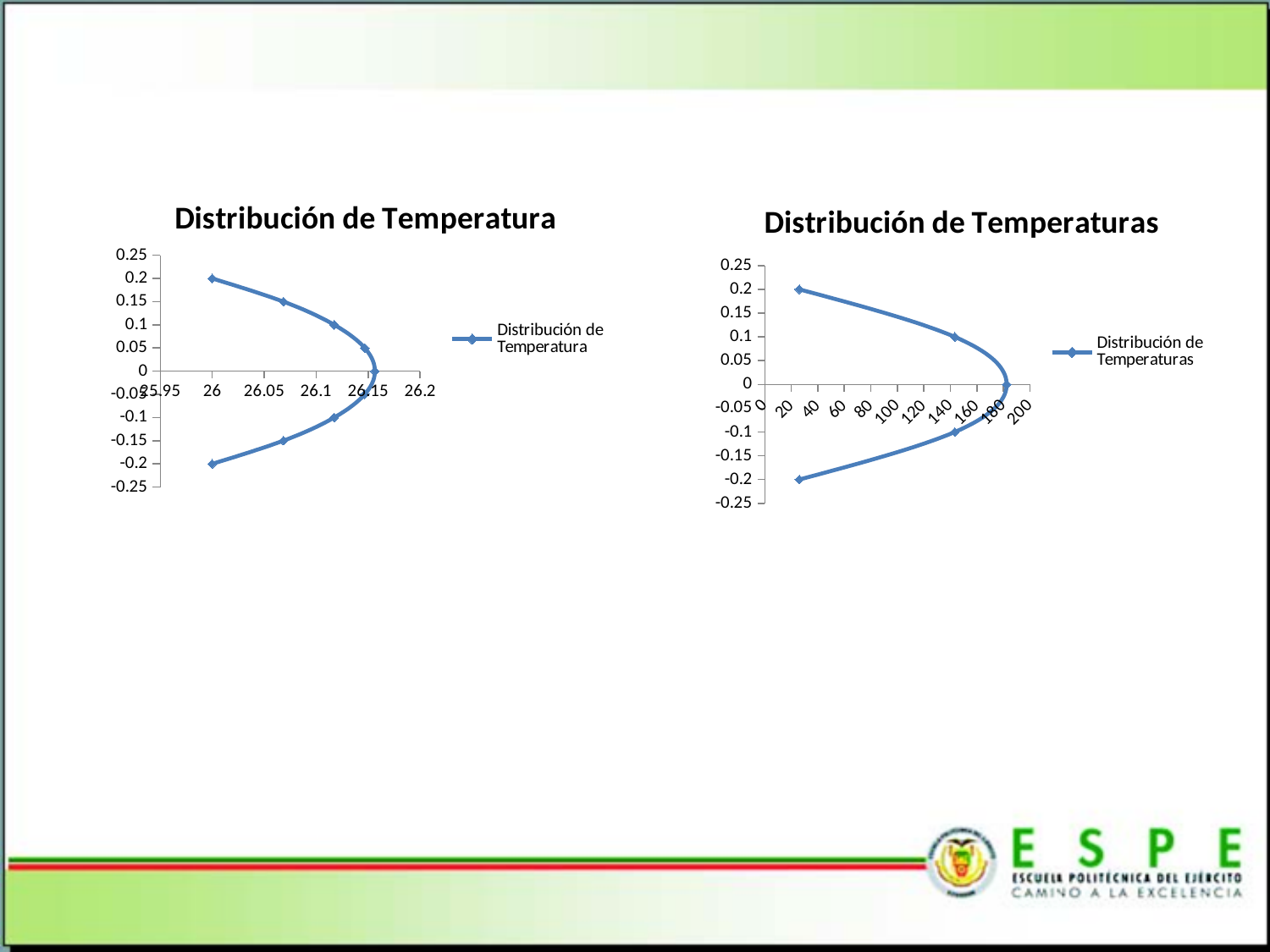
How many series does the legend of the left chart "Distribución de Temperatura" list? 1 How many data points are plotted on the right chart "Distribución de Temperaturas"? 5 In the left chart "Distribución de Temperatura", is the x value of the point at y = 0 greater or less than 26.1? greater What is the highest value shown on the x axis of the right chart "Distribución de Temperaturas"? 200 In the right chart "Distribución de Temperaturas", is the x value of the point at y = 0 greater or less than 160? greater How many series does the legend of the right chart "Distribución de Temperaturas" list? 1 What is the legend entry of the right chart "Distribución de Temperaturas"? Distribución de Temperaturas In the left chart "Distribución de Temperatura", is the x value of the point at y = 0.2 greater or less than 26.05? less What kind of chart is the right chart titled "Distribución de Temperaturas"? line chart How many data points are plotted on the left chart "Distribución de Temperatura"? 9 What kind of chart is the left chart titled "Distribución de Temperatura"? line chart